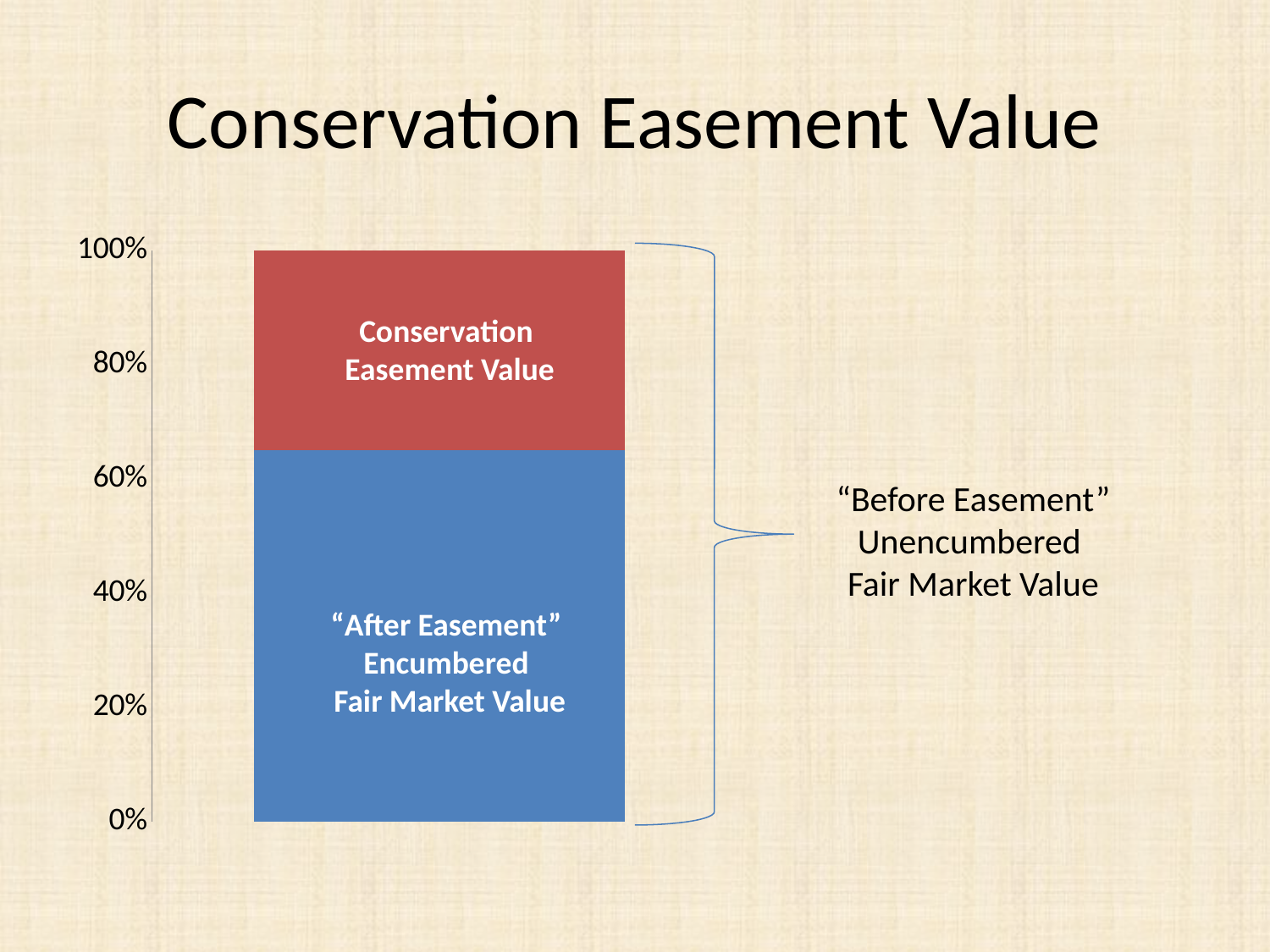
What is the title of the slide? Conservation Easement Value Which segment of the bar is the smallest? Conservation Easement Value What colour is the Conservation Easement Value segment? Red What is the highest value shown on the vertical axis? 100% Is the value for Conservation Easement Value greater or less than 40%? less Which segment is larger, "After Easement" Encumbered Fair Market Value or Conservation Easement Value? "After Easement" Encumbered Fair Market Value Which segment of the bar is the largest? "After Easement" Encumbered Fair Market Value What is the total height of the stacked bar on the percentage axis? 100% What kind of chart is shown on the slide? Stacked bar chart How many segments make up the stacked bar? 2 Is the value for "After Easement" Encumbered Fair Market Value greater or less than 60%? greater Is the value for "After Easement" Encumbered Fair Market Value greater or less than 80%? less